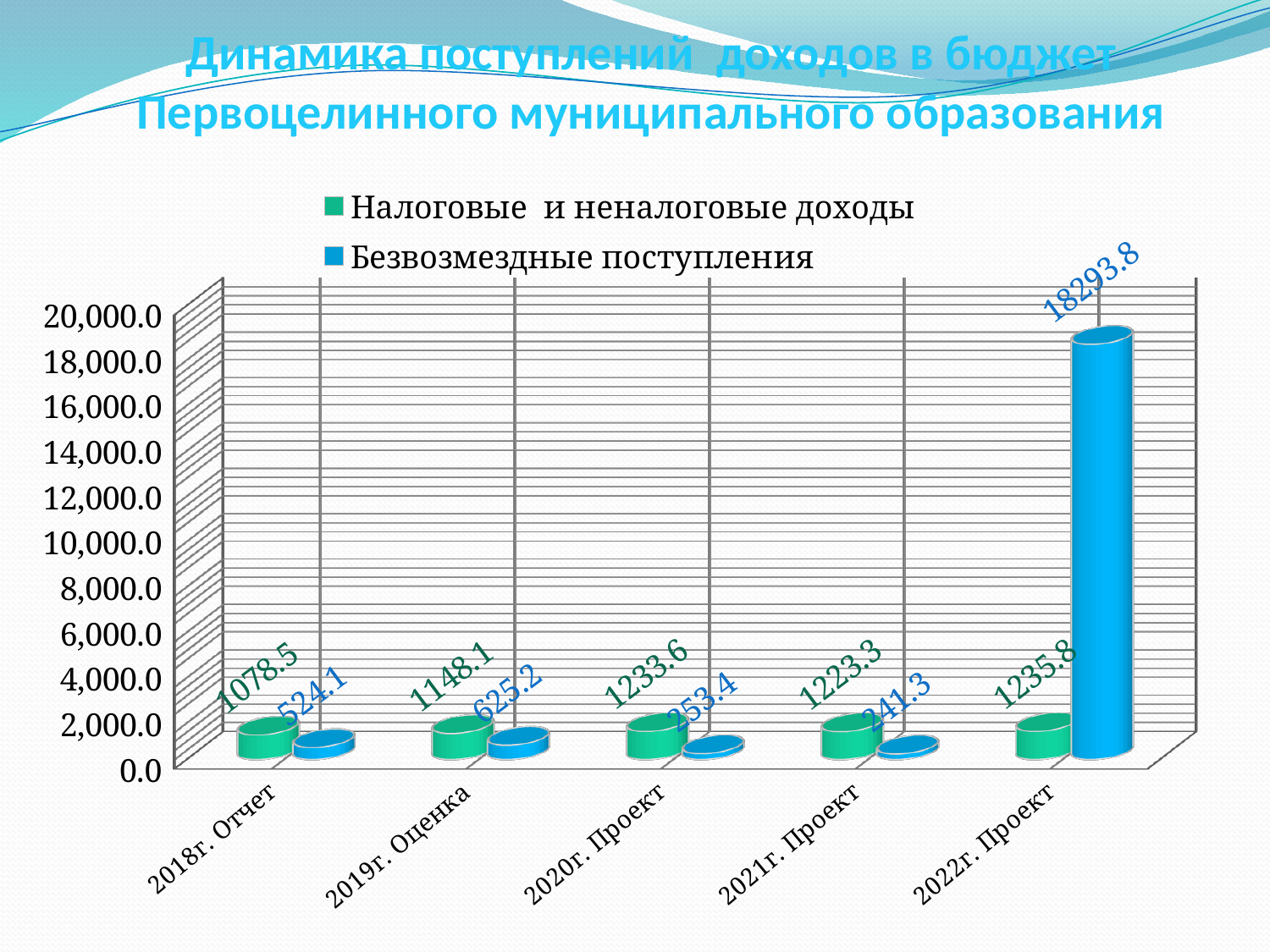
What is the value of Безвозмездные поступления for 2020г. Проект? 253.4 Which series is shown in green in the legend? Налоговые и неналоговые доходы What is the value of Безвозмездные поступления for 2022г. Проект? 18293.8 How many categories are shown on the x axis? 5 What kind of chart is shown on the slide? Bar chart Which category has the highest value for Безвозмездные поступления? 2022г. Проект Which is larger: Налоговые и неналоговые доходы for 2020г. Проект or for 2019г. Оценка? 2020г. Проект What is the difference between Безвозмездные поступления for 2019г. Оценка and 2018г. Отчет? 101.1 What is the value of Налоговые и неналоговые доходы for 2021г. Проект? 1223.3 What is the value of Налоговые и неналоговые доходы for 2018г. Отчет? 1078.5 How many series does the legend list? 2 Which category has the lowest value for Налоговые и неналоговые доходы? 2018г. Отчет